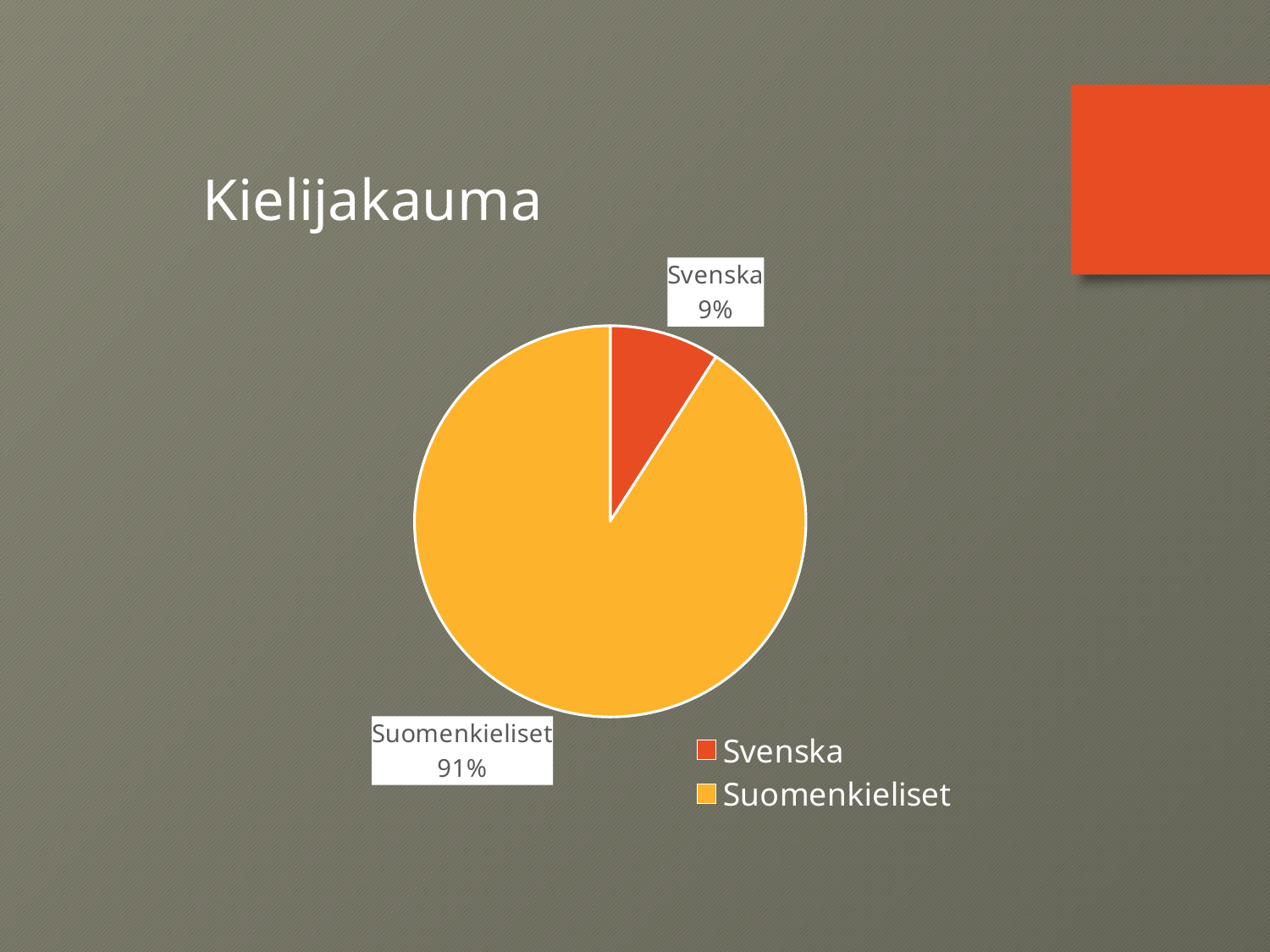
What is the title of the slide containing the pie chart? Kielijakauma What share of the pie does Suomenkieliset represent? 91% What colour is the Svenska slice in the pie chart? red-orange Which slice of the pie is the largest? Suomenkieliset What kind of chart is shown on the slide? pie chart How many slices does the pie chart have? 2 Which is larger, the Svenska slice or the Suomenkieliset slice? Suomenkieliset What share of the pie does Svenska represent? 9% What is the difference in percentage points between the Suomenkieliset and Svenska slices? 82 How many entries does the legend list? 2 Which slice of the pie is the smallest? Svenska